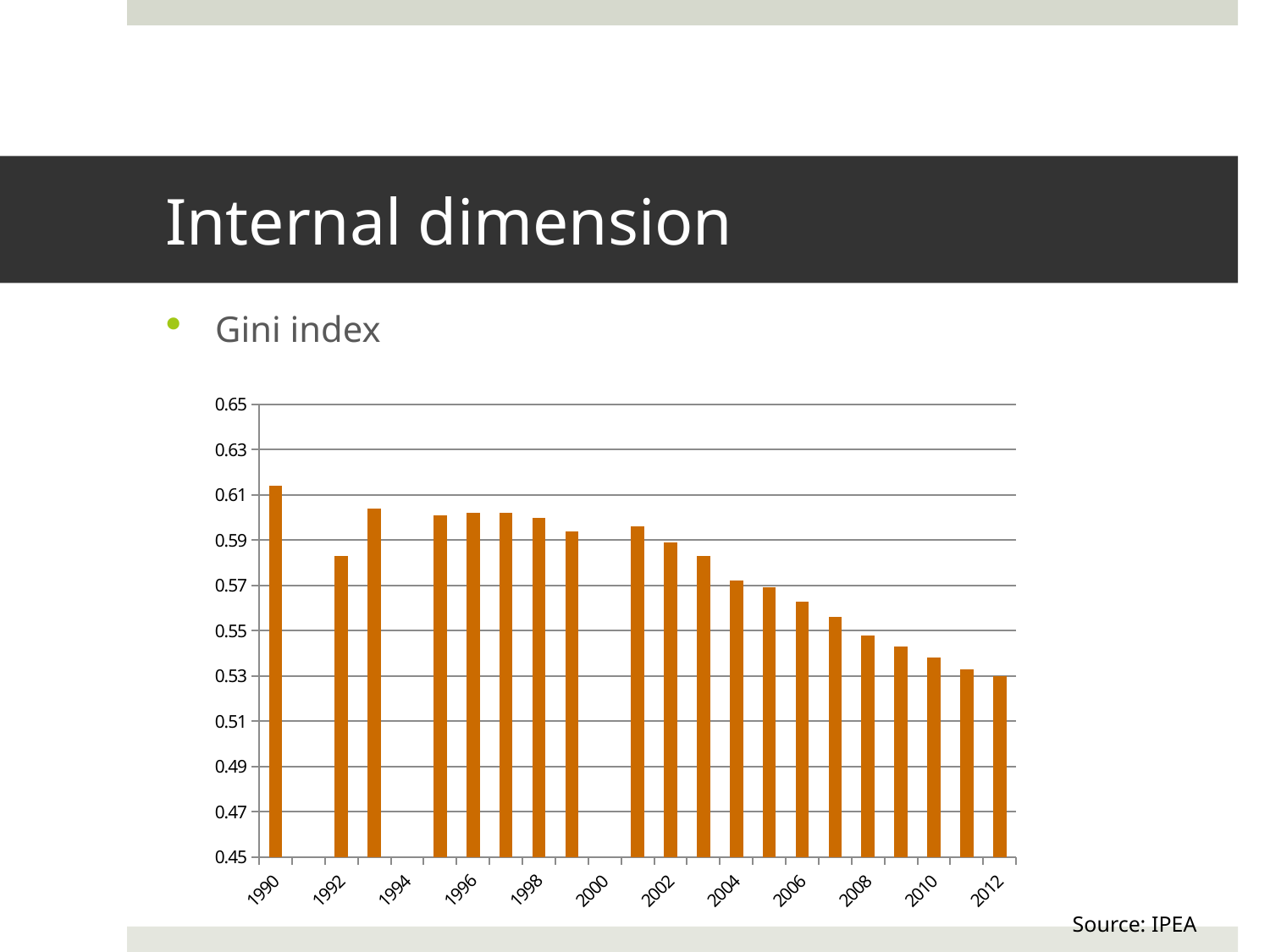
Which year has the larger Gini index value, 2004 or 2008? 2004 What kind of chart is shown on the slide? bar chart Is the Gini index value for 1990 greater or less than 0.59? greater Which year has the larger Gini index value, 1990 or 2012? 1990 Which year has the highest Gini index value in the chart? 1990 Which year has the larger Gini index value, 1992 or 1996? 1996 What source is cited for the chart data? IPEA Is the Gini index value for 2010 greater or less than 0.55? less Is the Gini index value for 2002 greater or less than 0.57? greater Overall, does the Gini index rise or fall from 1990 to 2012? fall